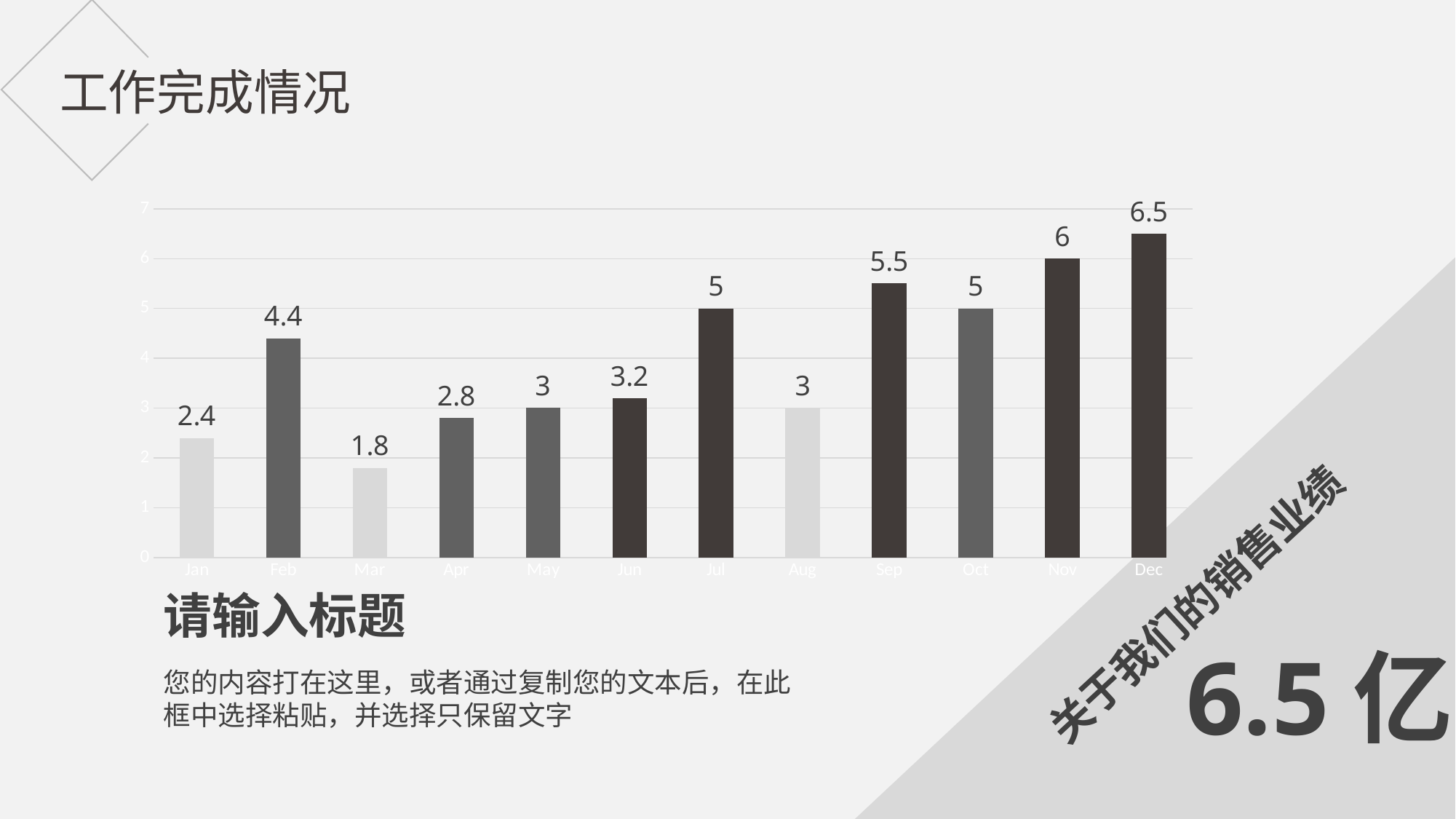
Which month has the highest value? Dec Which month has the lowest value? Mar What kind of chart is shown on the slide? bar chart What is the difference between the values for Dec and Jan? 4.1 Is the value for Nov greater or less than 5? greater What is the value for Feb? 4.4 What is the value for Sep? 5.5 Which is larger, the value for Jun or the value for Aug? Jun What is the difference between the values for Jul and Oct? 0 Do the values generally rise or fall from Sep to Dec? rise How many months are shown on the x axis? 12 What is the value for Mar? 1.8